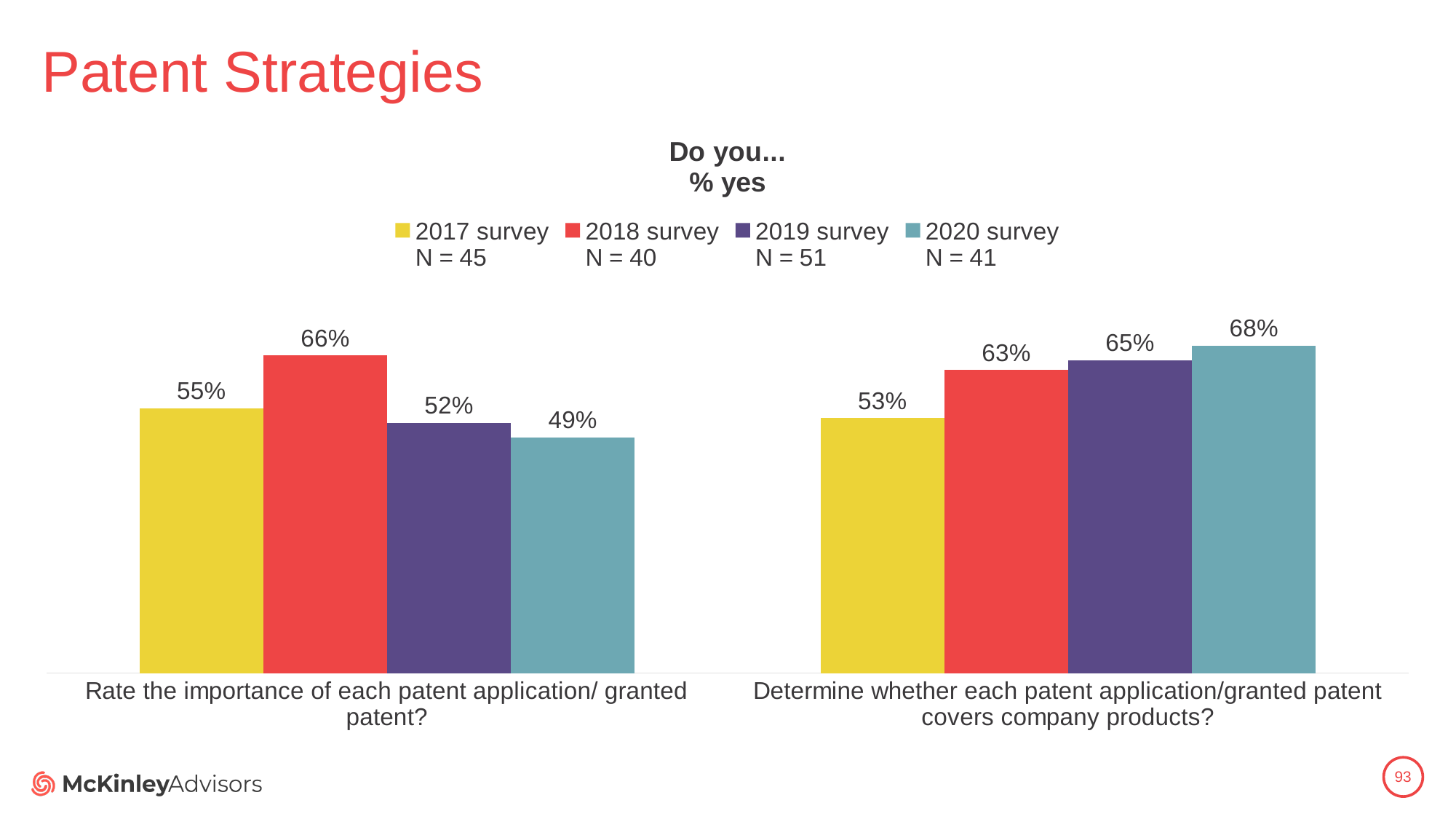
What percentage of 2018 survey respondents said yes to rating the importance of each patent application/granted patent? 66% What is the difference between the 2018 and 2020 survey values for 'Rate the importance of each patent application/granted patent?' 17 percentage points What percentage of 2020 survey respondents said yes to determining whether each patent application/granted patent covers company products? 68% Which survey year has the highest value for 'Rate the importance of each patent application/granted patent?' 2018 survey What is the 2017 survey value for 'Determine whether each patent application/granted patent covers company products?' 53% For the 2019 survey, which question had a higher share of yes responses: rating the importance of each patent, or determining whether each patent covers company products? Determine whether each patent application/granted patent covers company products? Which survey year has the highest value for 'Determine whether each patent application/granted patent covers company products?' 2020 survey What is the difference between the 2020 and 2017 survey values for 'Determine whether each patent application/granted patent covers company products?' 15 percentage points Which survey year has the lowest value for 'Rate the importance of each patent application/granted patent?' 2020 survey What type of chart is shown on the slide? Bar chart What is the sample size (N) for the 2019 survey shown in the legend? N = 51 How many survey series does the legend list? 4